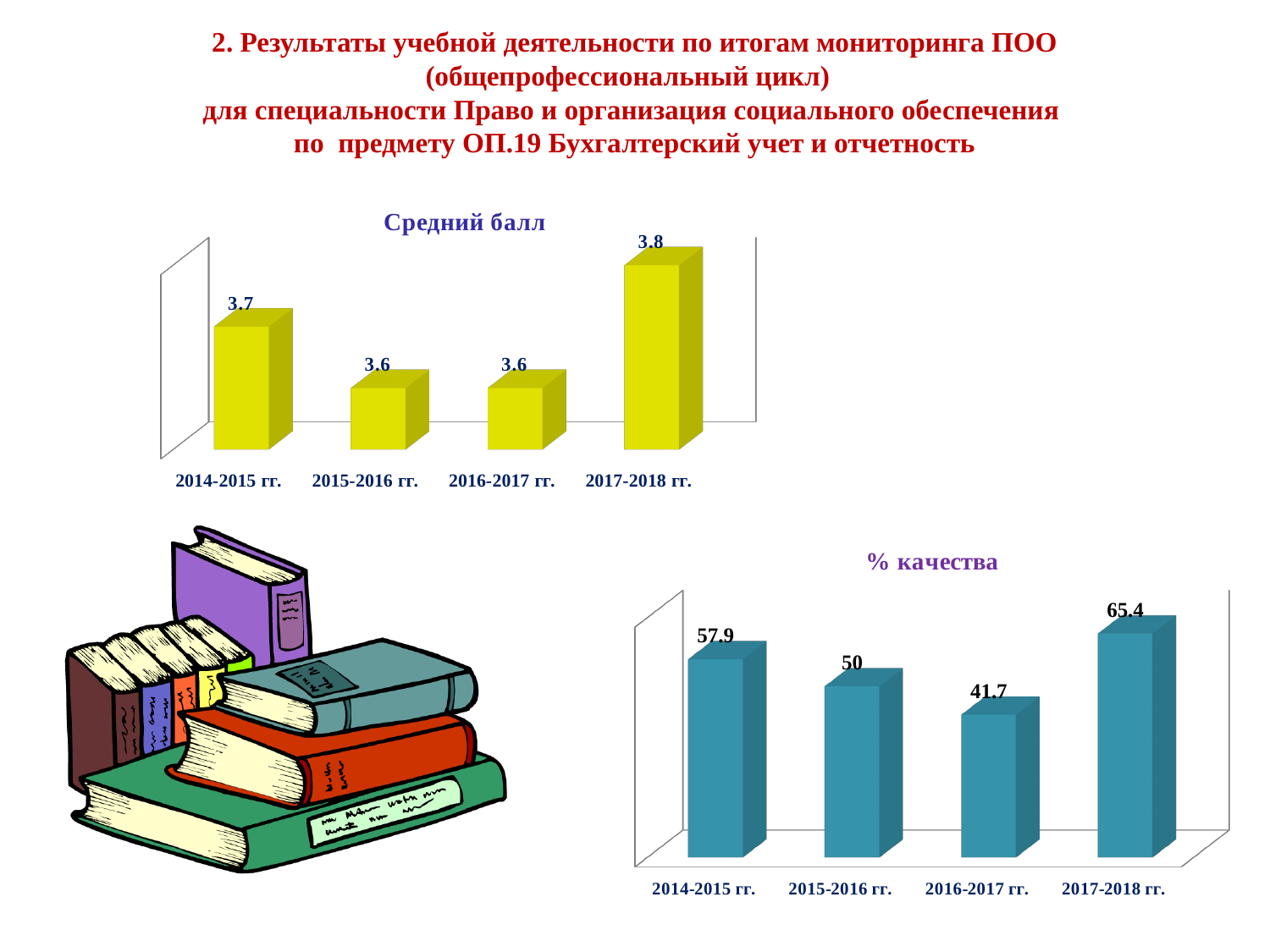
In the 'Средний балл' chart, what is the value for 2014-2015 гг.? 3.7 In the '% качества' chart, which year has the lowest value? 2016-2017 гг. In the 'Средний балл' chart, how many categories are shown on the x axis? 4 In the '% качества' chart, which is larger: the value for 2014-2015 гг. or 2015-2016 гг.? 2014-2015 гг. In the 'Средний балл' chart, which year has the highest value? 2017-2018 гг. What kind of chart is the '% качества' chart? Bar chart In the 'Средний балл' chart, what is the value for 2017-2018 гг.? 3.8 In the 'Средний балл' chart, what is the difference between the values for 2017-2018 гг. and 2016-2017 гг.? 0.2 In the '% качества' chart, what is the value for 2015-2016 гг.? 50 In the '% качества' chart, what is the value for 2016-2017 гг.? 41.7 In the '% качества' chart, what is the difference between the values for 2017-2018 гг. and 2014-2015 гг.? 7.5 In the '% качества' chart, which year has the highest value? 2017-2018 гг.